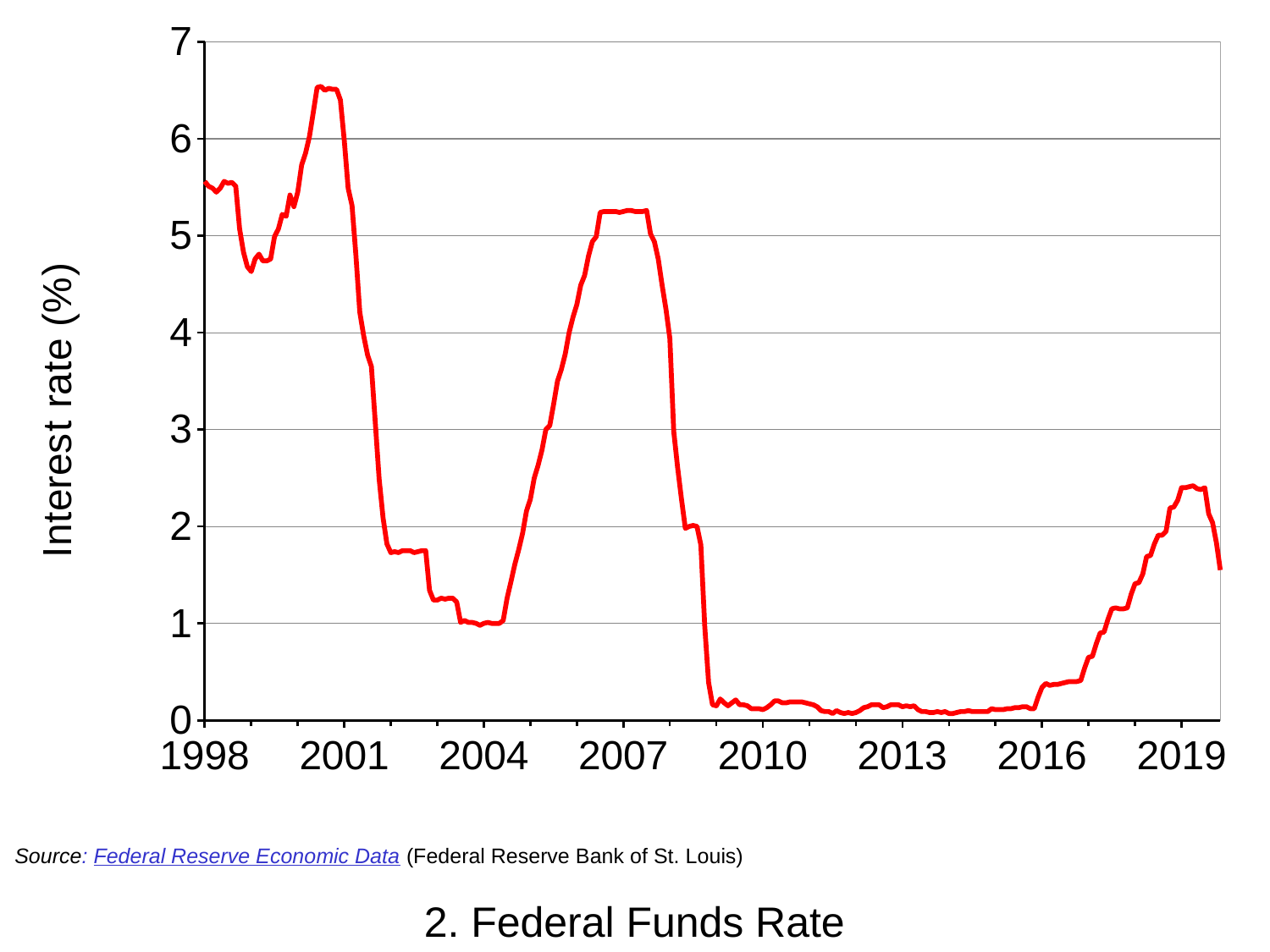
What is the title of the chart? 2. Federal Funds Rate Does the interest rate rise or fall between 2016 and 2019? rise What kind of chart is shown on the slide? Line chart Is the interest rate at 2010 greater or less than 1? less Is the interest rate at 2019 greater or less than 2? greater Is the interest rate at 2004 greater or less than 2? less What is the label on the y axis? Interest rate (%) How many year labels are shown on the x axis? 8 Does the interest rate rise or fall between 2007 and 2010? fall